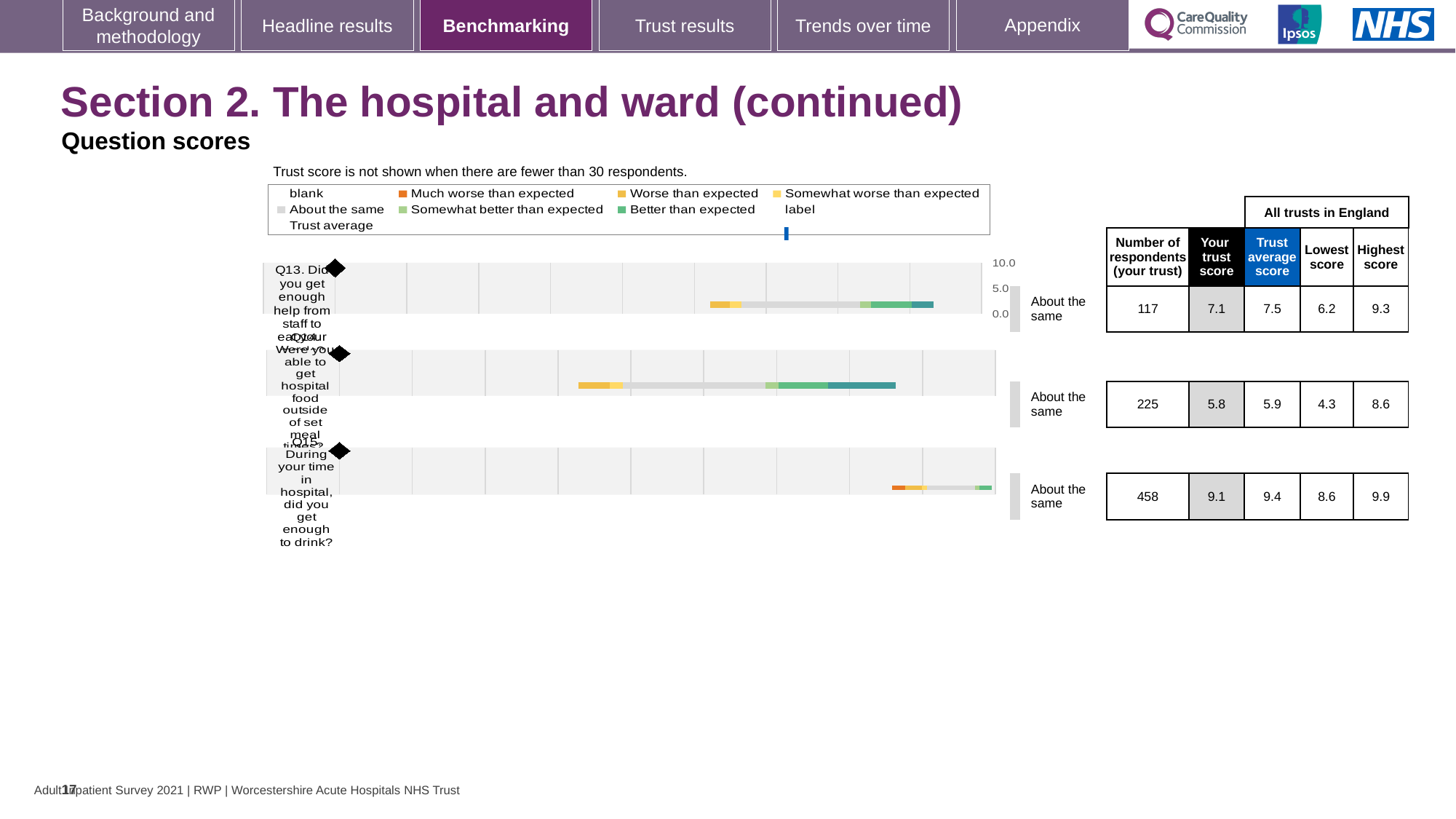
What is the highest score across all trusts in England for Q14? 8.6 What kind of chart is used to show the question scores on this slide? bar chart What benchmark category label is shown next to each of the three questions in the chart? About the same How many questions are plotted in the chart on this slide? 3 What is the 'Your trust score' for Q13 (Did you get enough help from staff to eat your meals?)? 7.1 Which question has the lowest 'Your trust score'? Q14 How many respondents are shown for Q14 (Were you able to get hospital food outside of set meal times?)? 225 Which question has the highest 'Your trust score'? Q15 What is the lowest score across all trusts in England for Q15? 8.6 What is the trust average score for Q15 (During your time in hospital, did you get enough to drink?)? 9.4 For Q13, what is the difference between the trust average score (7.5) and your trust score (7.1)? 0.4 For Q14, which is larger: your trust score or the trust average score? Trust average score